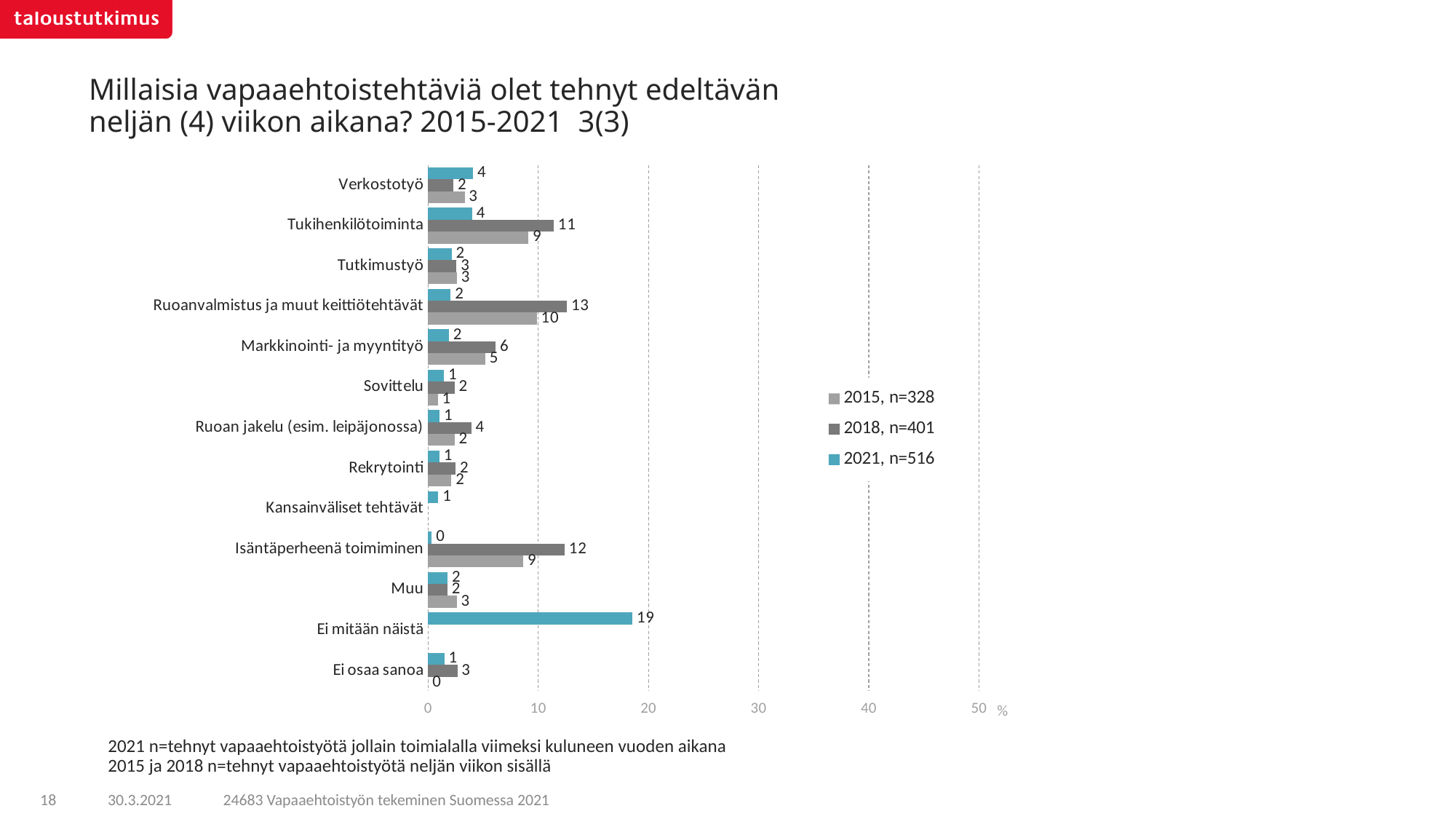
What is the 2021 value for Isäntäperheenä toimiminen? 0 What is the 2018 value for Ruoanvalmistus ja muut keittiötehtävät? 13 Which is larger for Isäntäperheenä toimiminen: the 2018 value or the 2015 value? 2018 What kind of chart is shown on the slide? Bar chart What is the difference between the 2018 and 2021 values for Tukihenkilötoiminta? 7 Which category has the highest 2018 value? Ruoanvalmistus ja muut keittiötehtävät How many categories are shown on the chart? 13 Which category has the highest 2021 value? Ei mitään näistä What is the 2021 value for Ei mitään näistä? 19 How many series does the legend list? 3 What is the sample size (n) for the 2021 series in the legend? 516 What is the 2015 value for Tukihenkilötoiminta? 9